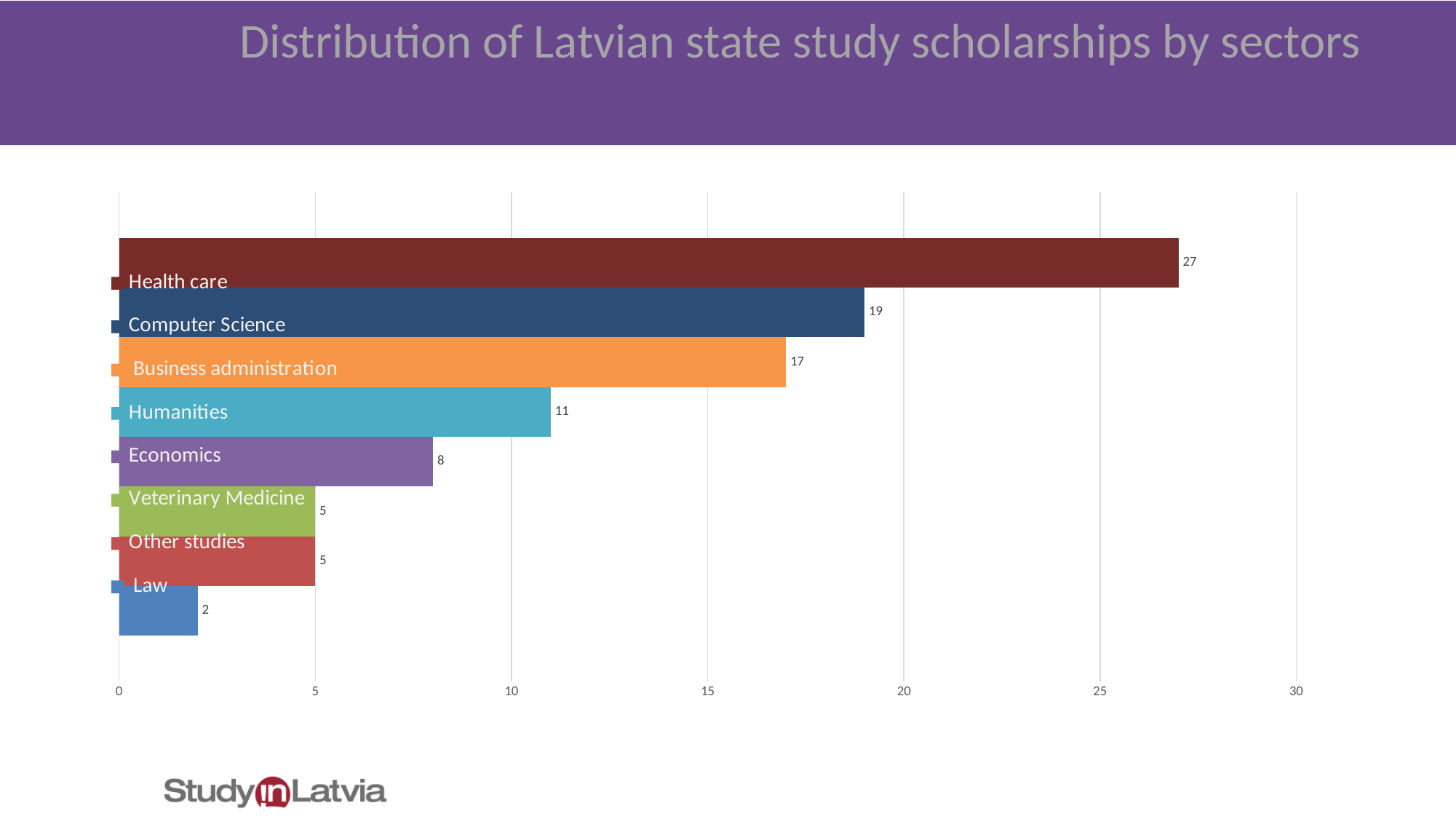
What is the value for Economics? 8 Which sector has the highest value? Health care What is the difference between the values for Health care and Computer Science? 8 Is the value for Humanities greater or less than 10? greater What is the title of the slide? Distribution of Latvian state study scholarships by sectors Which sector has the lowest value? Law Which is larger, the value for Computer Science or the value for Business administration? Computer Science What is the difference between the values for Humanities and Law? 9 How many sectors are shown in the chart? 8 What is the value for Health care? 27 What kind of chart is shown on the slide? bar chart What is the value for Business administration? 17